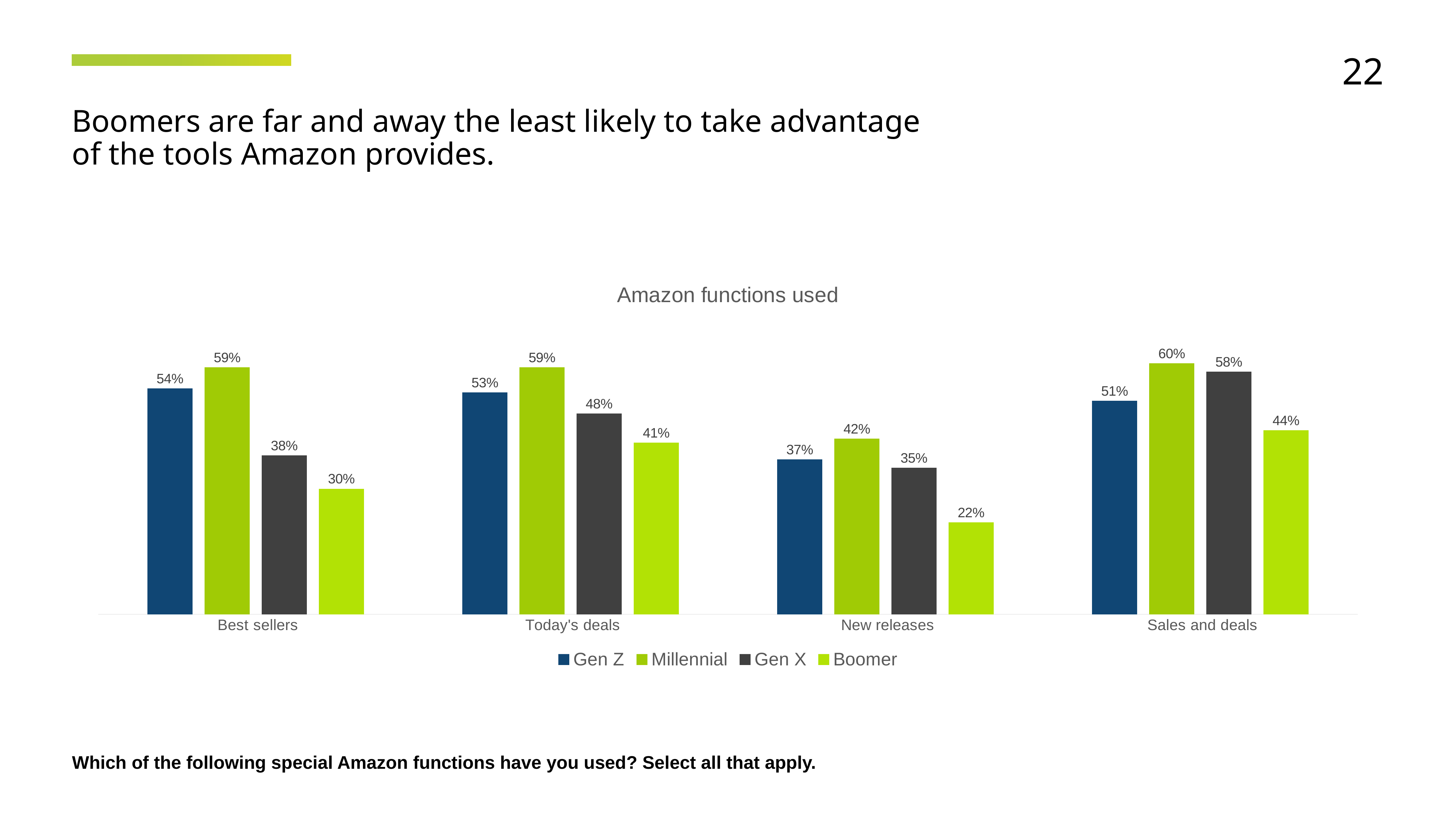
What kind of chart is shown on the slide? Bar chart What is the difference between the Millennial and Boomer values in the Best sellers category? 29% Which generation has the highest value in the Best sellers category? Millennial Which generation has the lowest value in the New releases category? Boomer What is the value for Boomer in the Best sellers category? 30% Which is larger in the Sales and deals category: the Gen Z value or the Boomer value? Gen Z How many categories are shown on the x axis? 4 How many series does the legend list? 4 What is the value for Gen X in the Today's deals category? 48% What is the value for Millennial in the Sales and deals category? 60% What is the title of the chart? Amazon functions used What is the value for Gen Z in the New releases category? 37%